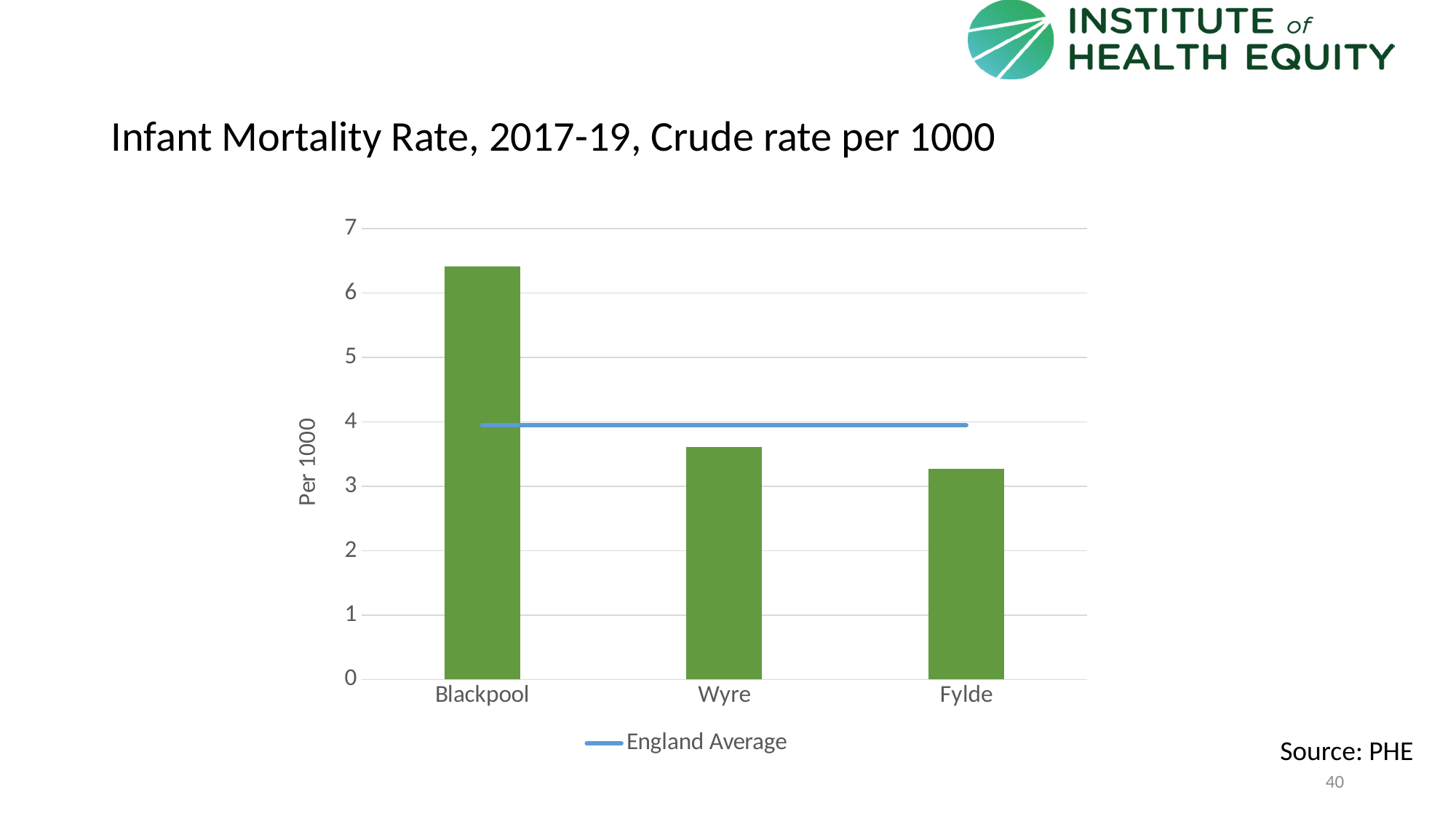
Which area has the lowest infant mortality rate in the chart? Fylde Is the value for Fylde greater or less than 3? greater Is the value for Blackpool greater or less than 6? greater What is the label on the vertical axis of the chart? Per 1000 Is the value for Wyre greater or less than 4? less Which area has the highest infant mortality rate in the chart? Blackpool Do the bar values rise or fall from left to right across the x axis? fall What kind of chart is shown on the slide? bar chart Which has the larger infant mortality rate, Blackpool or Wyre? Blackpool How many entries does the chart legend list? 1 Which has the larger infant mortality rate, Wyre or Fylde? Wyre How many areas are plotted as bars in the chart? 3